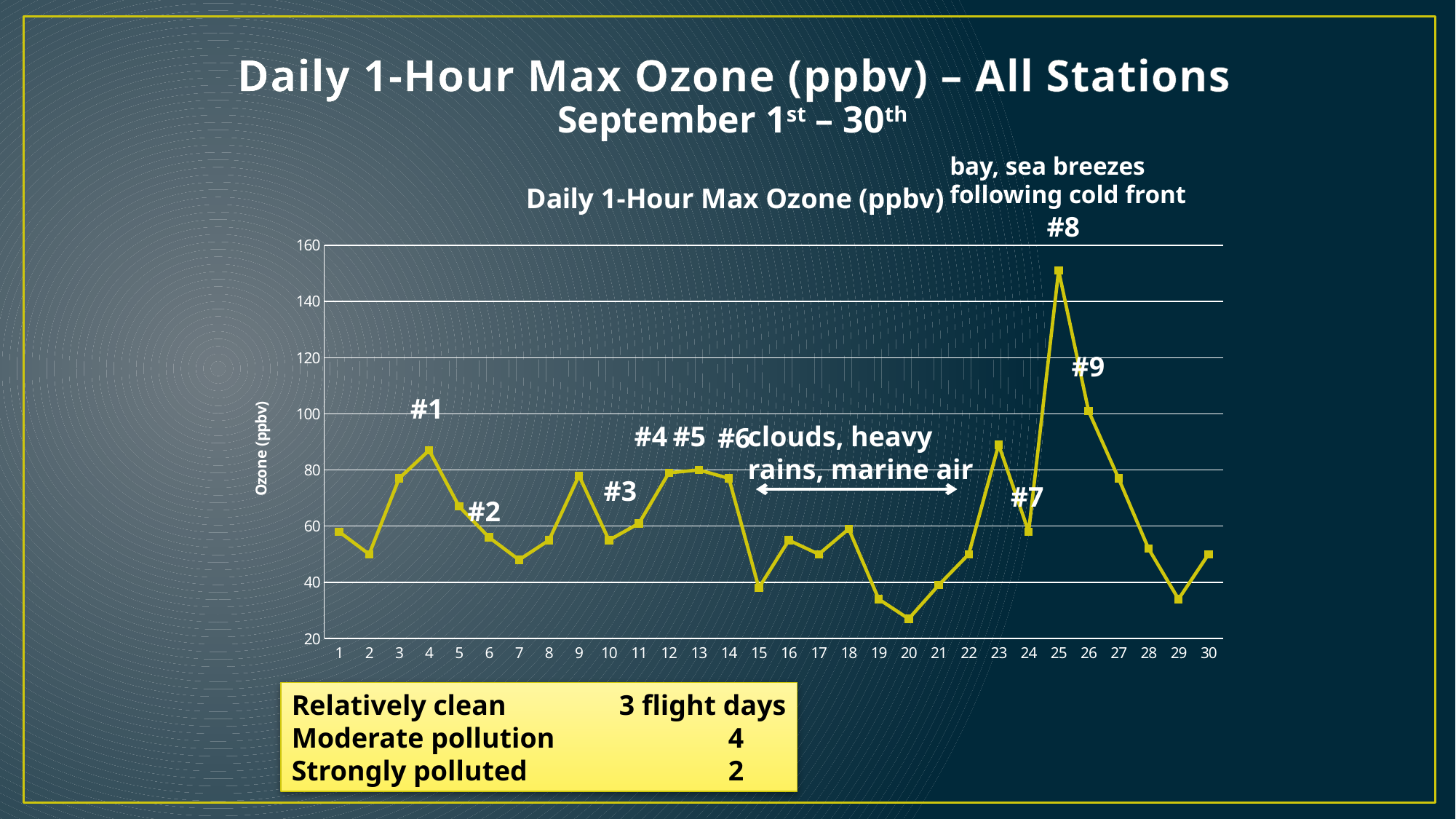
On which day of September is the daily 1-hour max ozone highest? 25 Do the values rise or fall from day 25 to day 29? fall How many days (data points) are plotted along the x axis? 30 What kind of chart is shown on the slide? line chart Is the value for day 7 greater or less than 60? less On which day of September is the daily 1-hour max ozone lowest? 20 Is the value for day 20 greater or less than 40? less What is the label on the y axis of the chart? Ozone (ppbv) Which day has the higher ozone value, day 20 or day 23? day 23 Is the value for day 25 greater or less than 140? greater Which day has the higher ozone value, day 9 or day 10? day 9